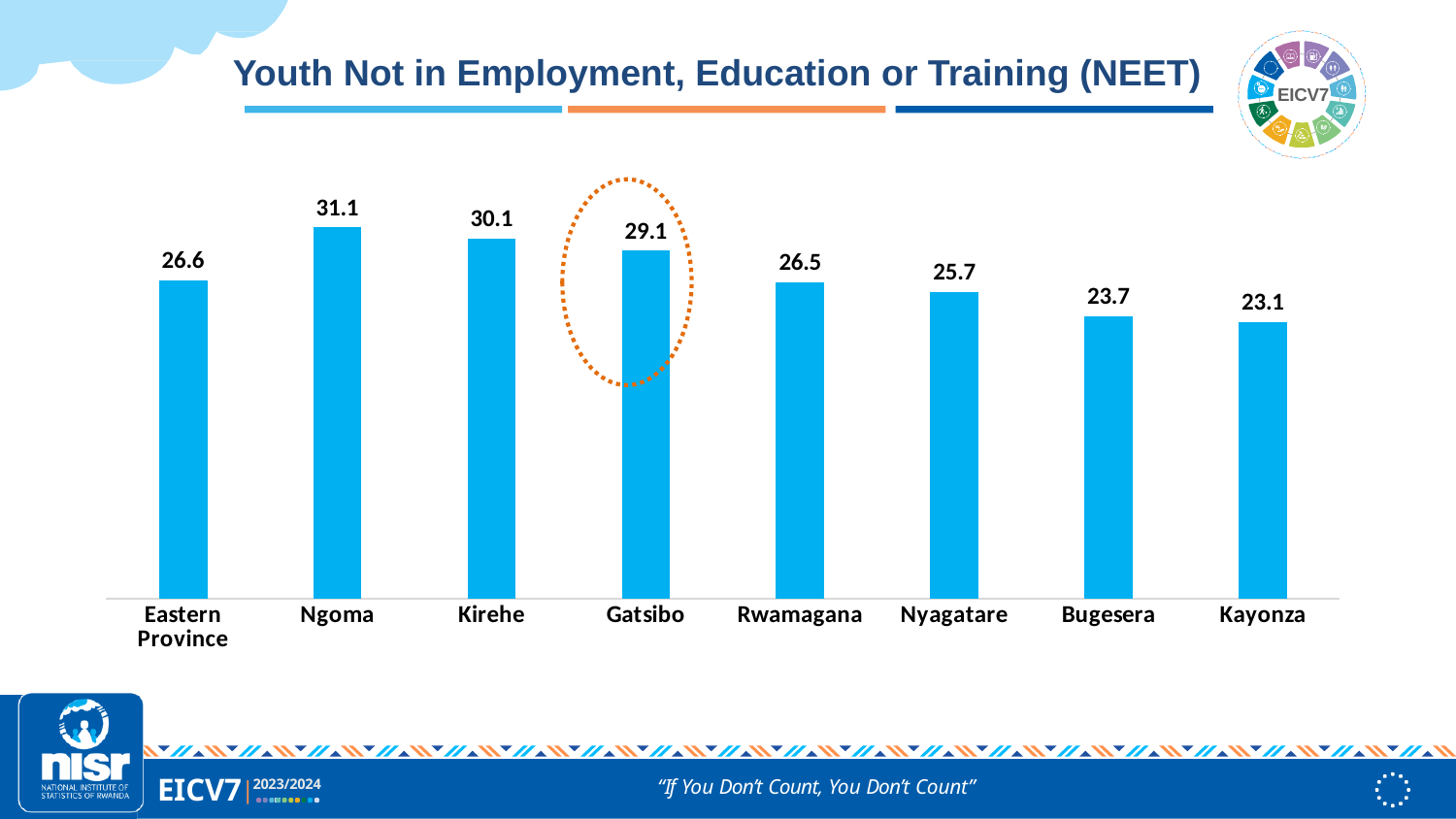
What is the NEET value for Gatsibo? 29.1 What is the difference between the NEET values for Ngoma and Kayonza? 8.0 Which has a higher NEET value, Kirehe or Bugesera? Kirehe What is the NEET value for Eastern Province? 26.6 What is the NEET value for Bugesera? 23.7 How many categories are shown on the x axis of the chart? 8 Which has a higher NEET value, Nyagatare or Rwamagana? Rwamagana Which category has the lowest NEET value? Kayonza What kind of chart is shown on the slide? Bar chart Which bar on the chart is highlighted with a dotted orange circle? Gatsibo What is the difference between the NEET values for Kirehe and Gatsibo? 1.0 Which district has the highest NEET value? Ngoma